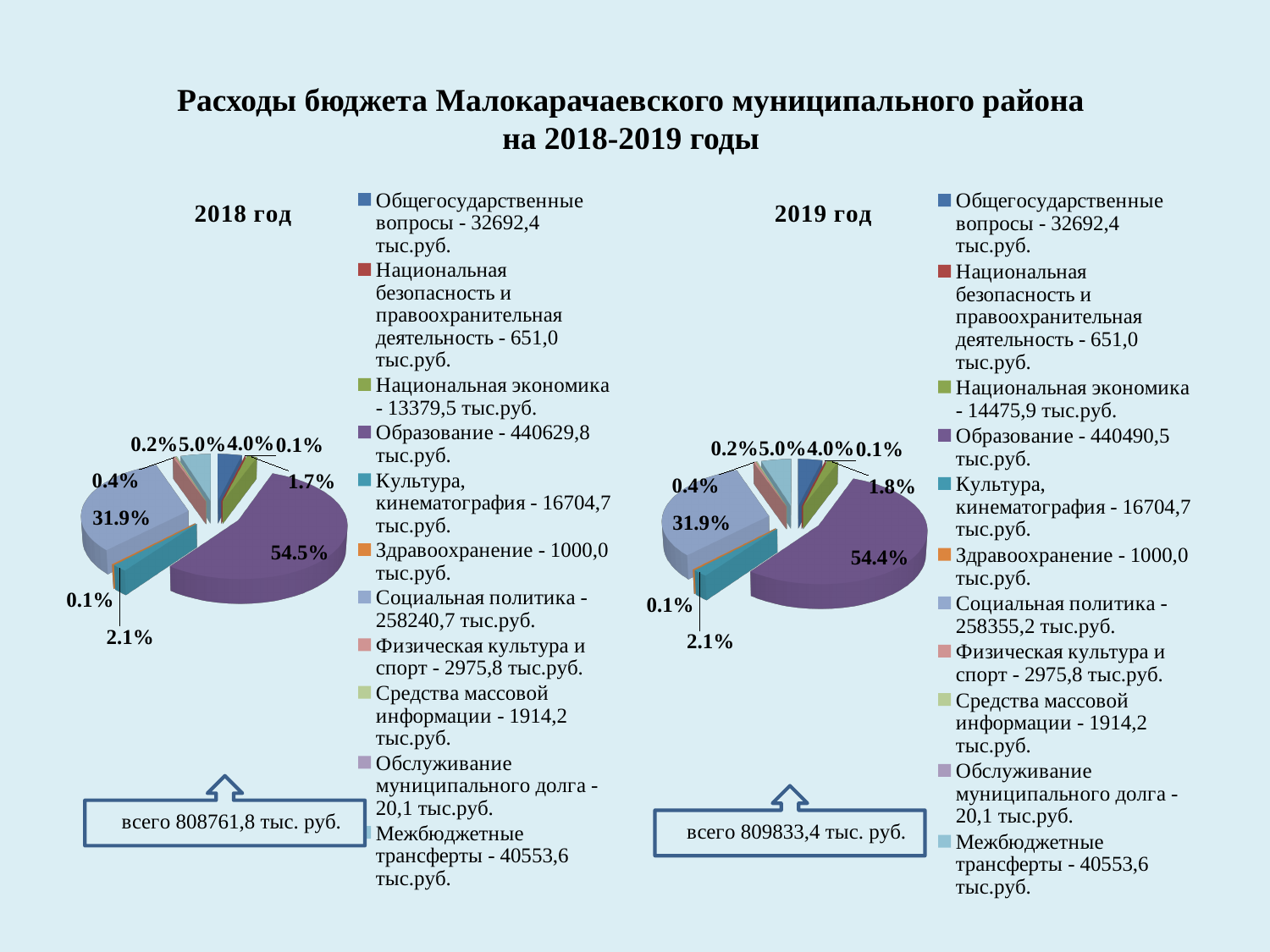
How many categories does the legend of the 2019 год chart list? 11 In the 2019 год chart, what percentage is shown on the largest slice? 54.4% What is the difference between the total shown for 2019 год and the total shown for 2018 год? 1071,6 тыс. руб. In the 2018 год chart, what is the value for Образование according to the legend? 440629,8 тыс.руб. By how much does the value for Национальная экономика in the 2019 год chart exceed the value in the 2018 год chart? 1096,4 тыс.руб. What total expenditure is shown below the 2018 год chart? всего 808761,8 тыс. руб. In the 2019 год chart, what is the value for Здравоохранение according to the legend? 1000,0 тыс.руб. In the 2018 год chart, which category has the largest slice? Образование In the 2018 год chart, which is larger: Социальная политика or Межбюджетные трансферты? Социальная политика What kind of chart is used for the 2018 год data? pie chart In the 2019 год chart, what is the value for Национальная экономика according to the legend? 14475,9 тыс.руб. In the 2018 год chart, what share of the pie does Образование take? 54.5%